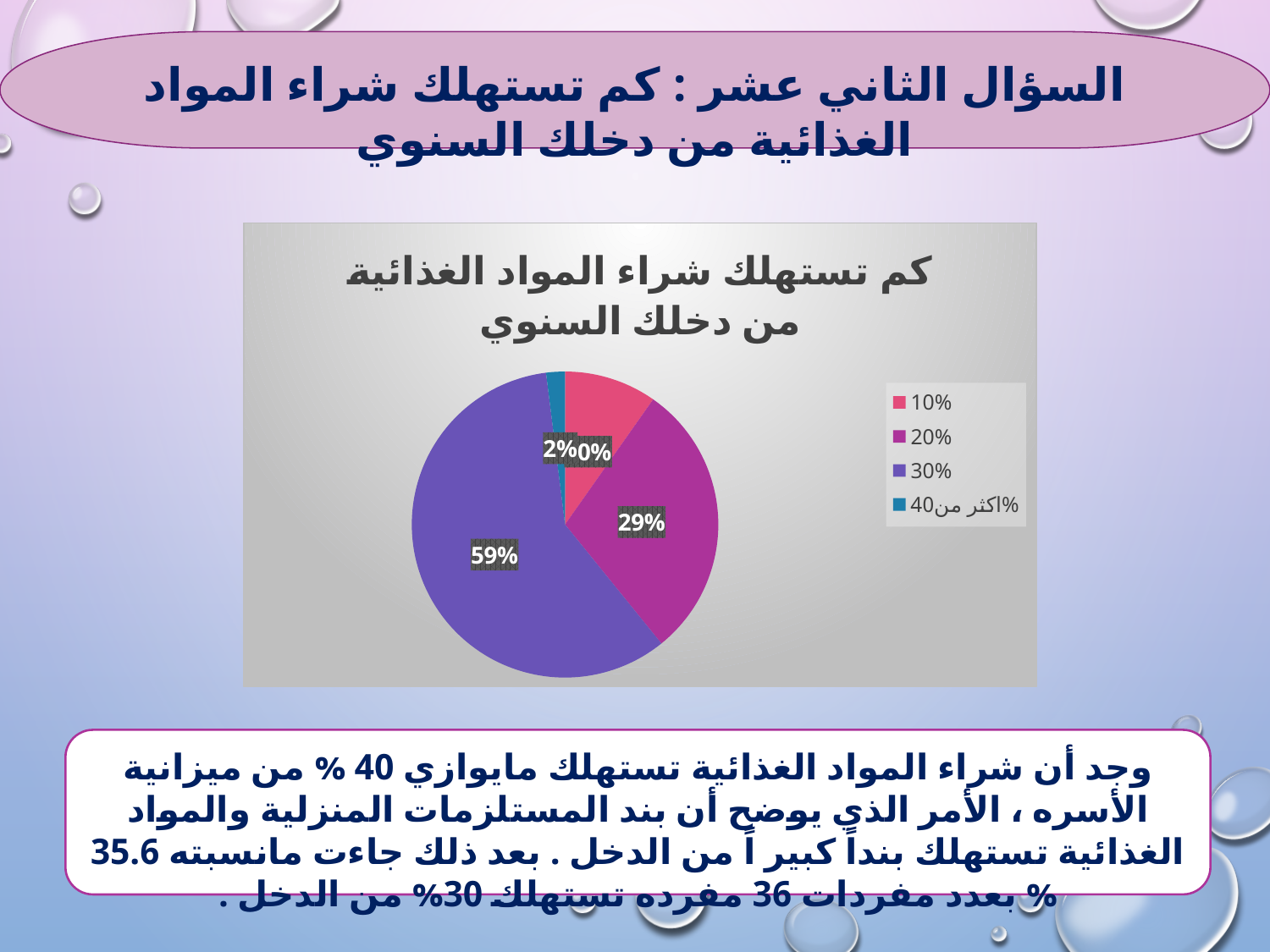
What colour is the slice for the 30% category? purple What share of the pie does the 30% category take? 59% What share of the pie does the 20% category take? 29% Which category has the largest slice of the pie? 30% By how many percentage points does the 30% slice exceed the 20% slice? 30 Which category has the smallest slice of the pie? اكثر من40% How many categories does the legend of the pie chart list? 4 What is the title of the pie chart? كم تستهلك شراء المواد الغذائية من دخلك السنوي Which slice is larger, the 30% category or the 20% category? 30% Is the share of the 30% category greater or less than 50%? greater What share of the pie does the اكثر من40% category take? 2% What kind of chart is shown on the slide? pie chart